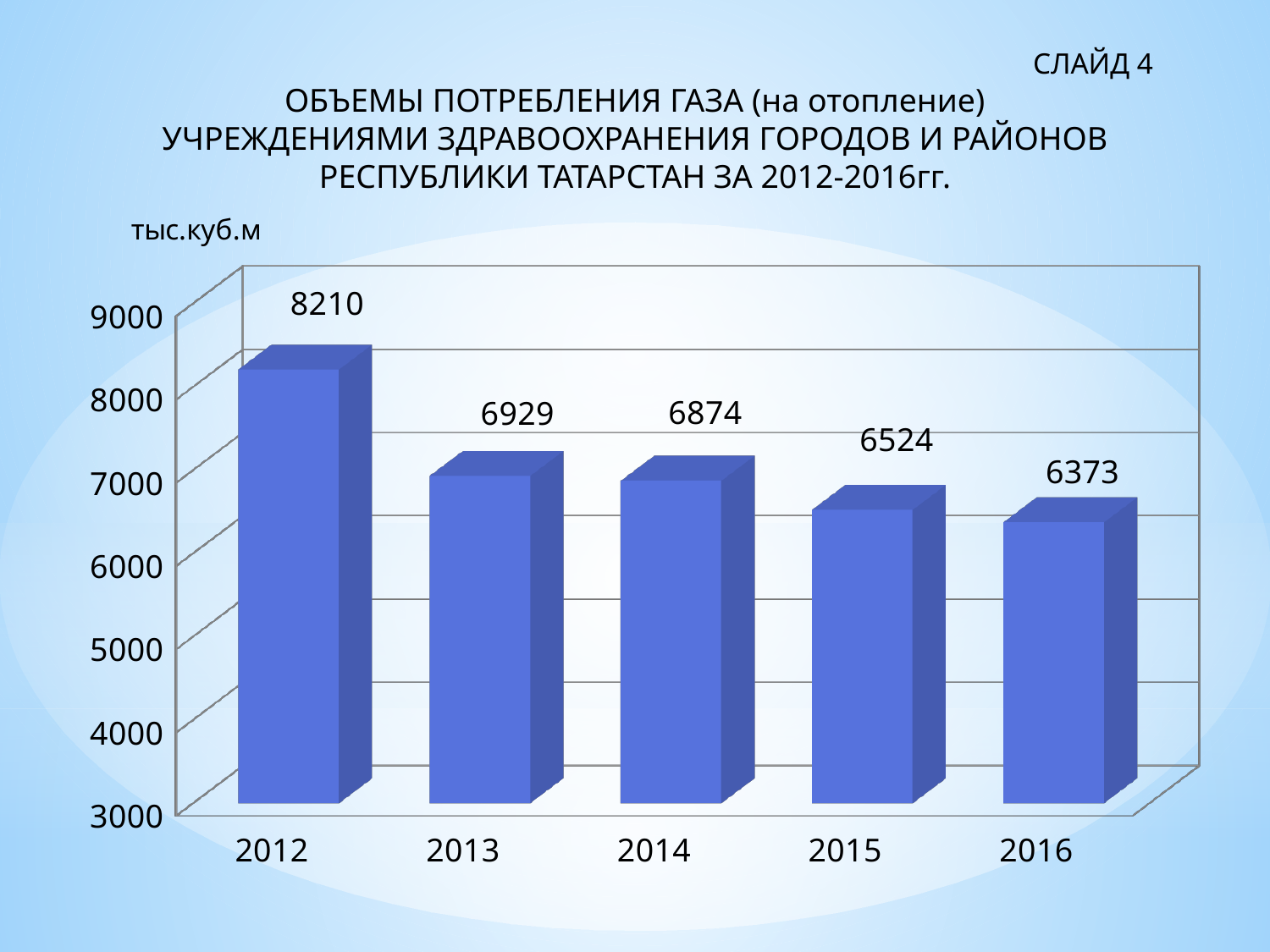
Which year has the lowest gas consumption? 2016 What is the gas consumption value for 2016? 6373 Which year has the highest gas consumption? 2012 How many years are shown on the chart? 5 What is the difference between the values for 2012 and 2013? 1281 Do the values rise or fall from 2012 to 2016? fall Which year has a larger value, 2013 or 2014? 2013 What is the gas consumption value for 2012? 8210 What is the gas consumption value for 2015? 6524 What is the difference between the values for 2015 and 2016? 151 Is the value for 2014 greater or less than 7000? less What kind of chart is shown on the slide? bar chart